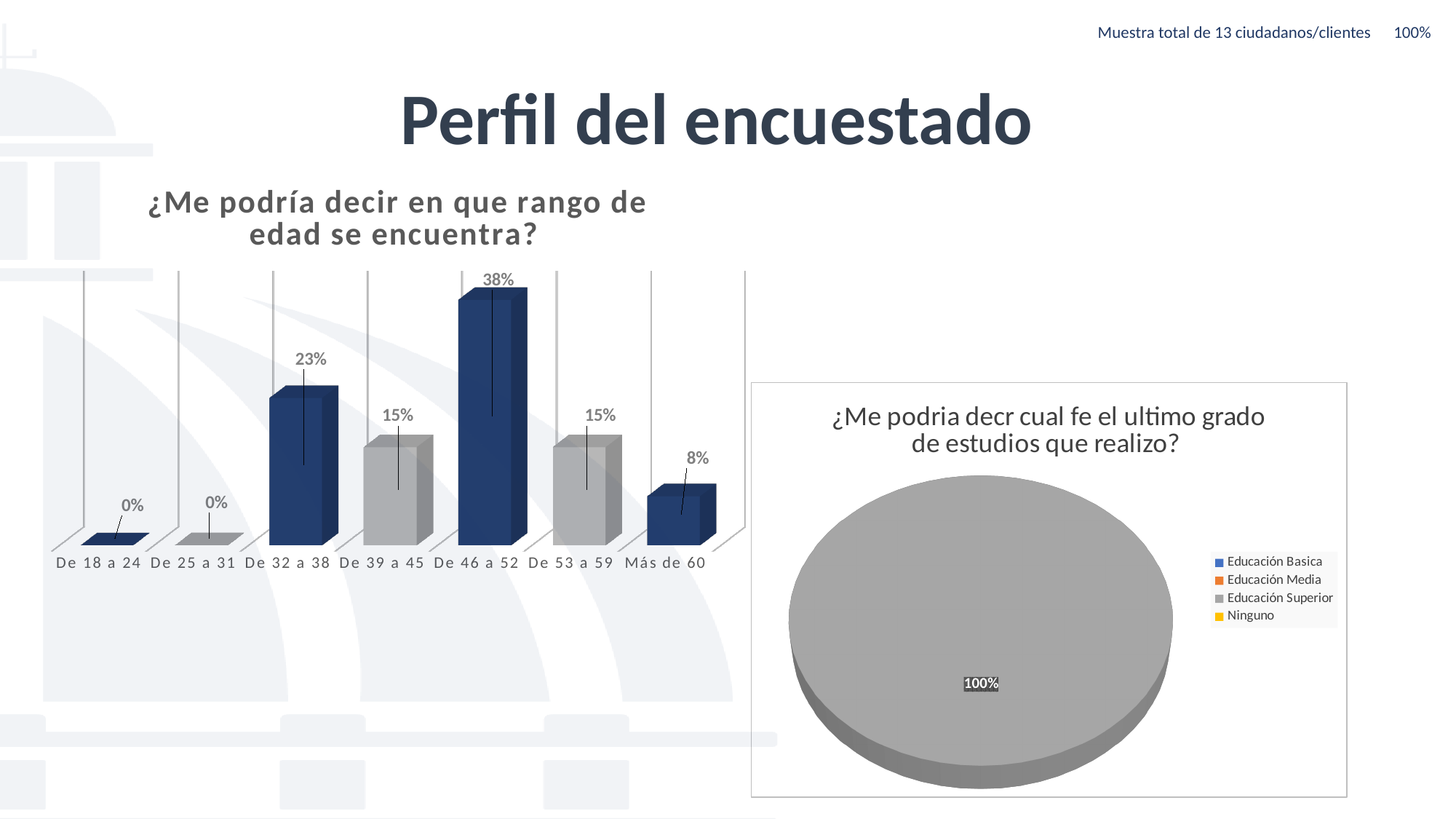
In the age range chart, what is the difference between the 'De 46 a 52' and 'De 32 a 38' percentages? 15% In the age range chart, how many categories have a value of 0%? 2 What kind of chart is used for the last level of education question? Pie chart In the age range chart, what percentage of respondents are 'Más de 60'? 8% In the age range chart, which age range has the highest percentage? De 46 a 52 In the age range chart, what percentage of respondents are in the 'De 46 a 52' range? 38% In the age range chart, what percentage of respondents are in the 'De 32 a 38' range? 23% What kind of chart is used for the age range question? Bar chart In the education level pie chart, what share is shown for Educación Superior? 100% How many age range categories are shown in the age range chart? 7 How many entries does the legend of the education level pie chart list? 4 In the age range chart, which is larger: 'De 39 a 45' or 'Más de 60'? De 39 a 45